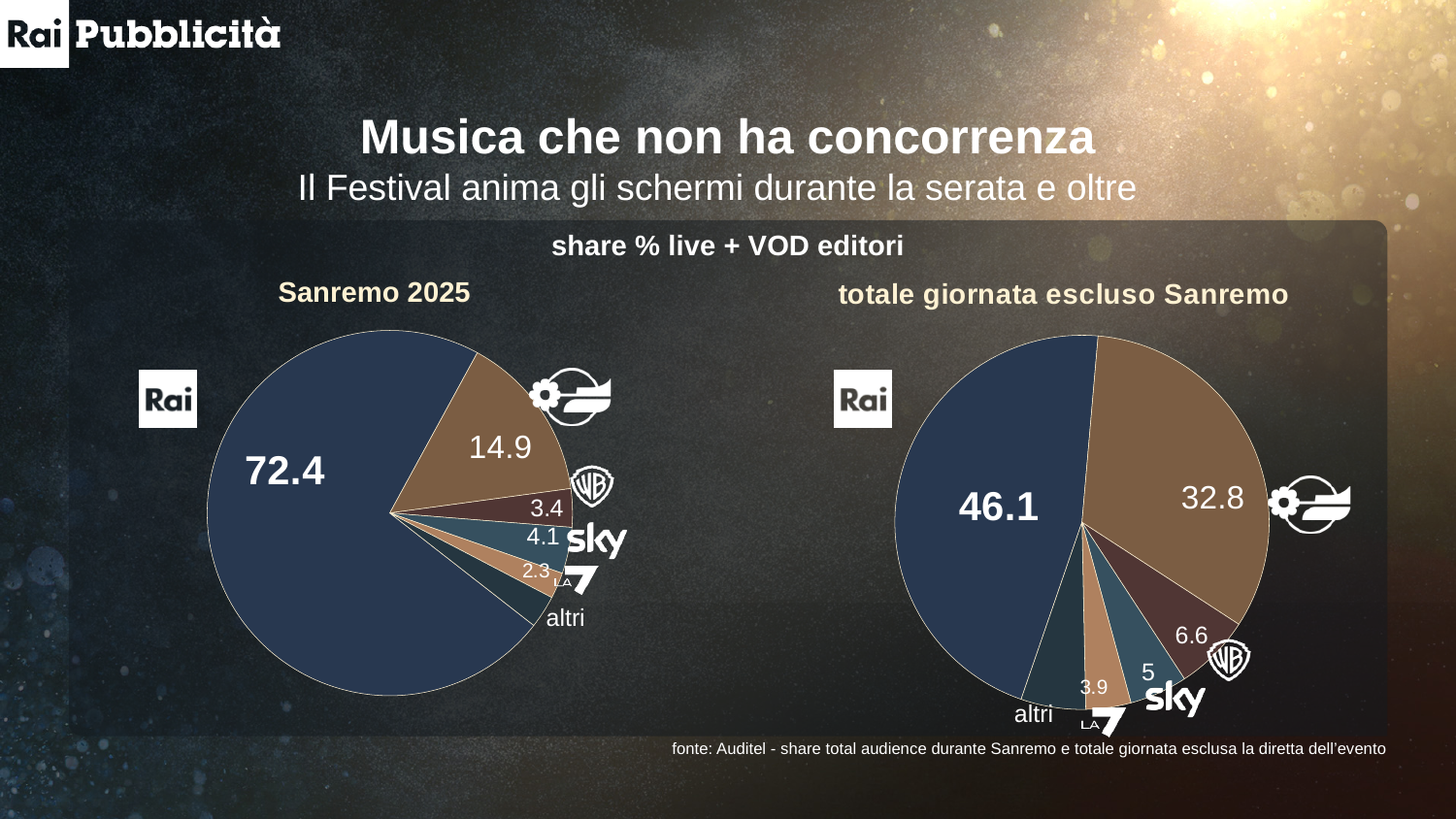
In the Sanremo 2025 pie chart, which slice is the largest? Rai In the 'totale giornata escluso Sanremo' pie chart, what share is shown for Sky? 5 What kind of chart is used for Sanremo 2025? Pie chart In the 'totale giornata escluso Sanremo' pie chart, what share is shown for La7? 3.9 How much higher is Rai's share in the Sanremo 2025 chart than in the 'totale giornata escluso Sanremo' chart? 26.3 In the 'totale giornata escluso Sanremo' pie chart, what share is shown for WB? 6.6 In the Sanremo 2025 pie chart, what share is shown for La7? 2.3 In the Sanremo 2025 pie chart, which has the larger share, Sky or WB? Sky How many slices does the 'totale giornata escluso Sanremo' pie chart have? 6 In the Sanremo 2025 pie chart, what share is shown for Sky? 4.1 In the 'totale giornata escluso Sanremo' pie chart, what share is shown for Rai? 46.1 In the Sanremo 2025 pie chart, what share is shown for Rai? 72.4